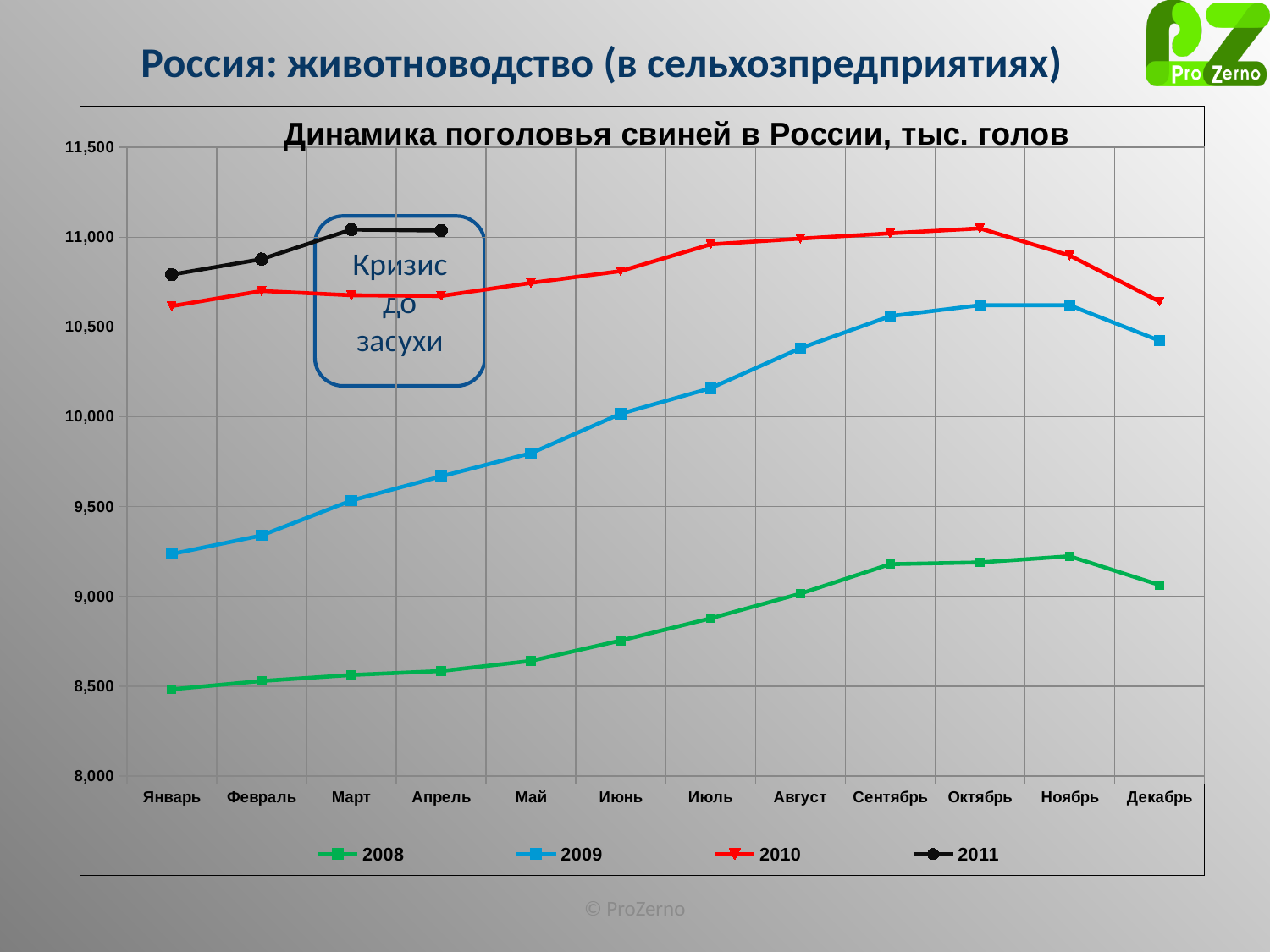
Does the 2009 series rise or fall from Январь to Октябрь? rise In which month is the 2009 series at its lowest value? Январь Which series has the larger value in Июнь, 2009 or 2010? 2010 Is the value for 2010 in Октябрь greater or less than 11,000? greater Is the value for 2009 in Октябрь greater or less than 10,500? greater For how many months does the 2011 series have data points? 4 In which month does the 2010 series reach its highest value? Октябрь What kind of chart is shown on the slide? line chart Is the value for 2008 in Декабрь greater or less than 9,000? greater How many series does the legend list? 4 How many months are shown on the x axis? 12 What is the title of the chart? Динамика поголовья свиней в России, тыс. голов